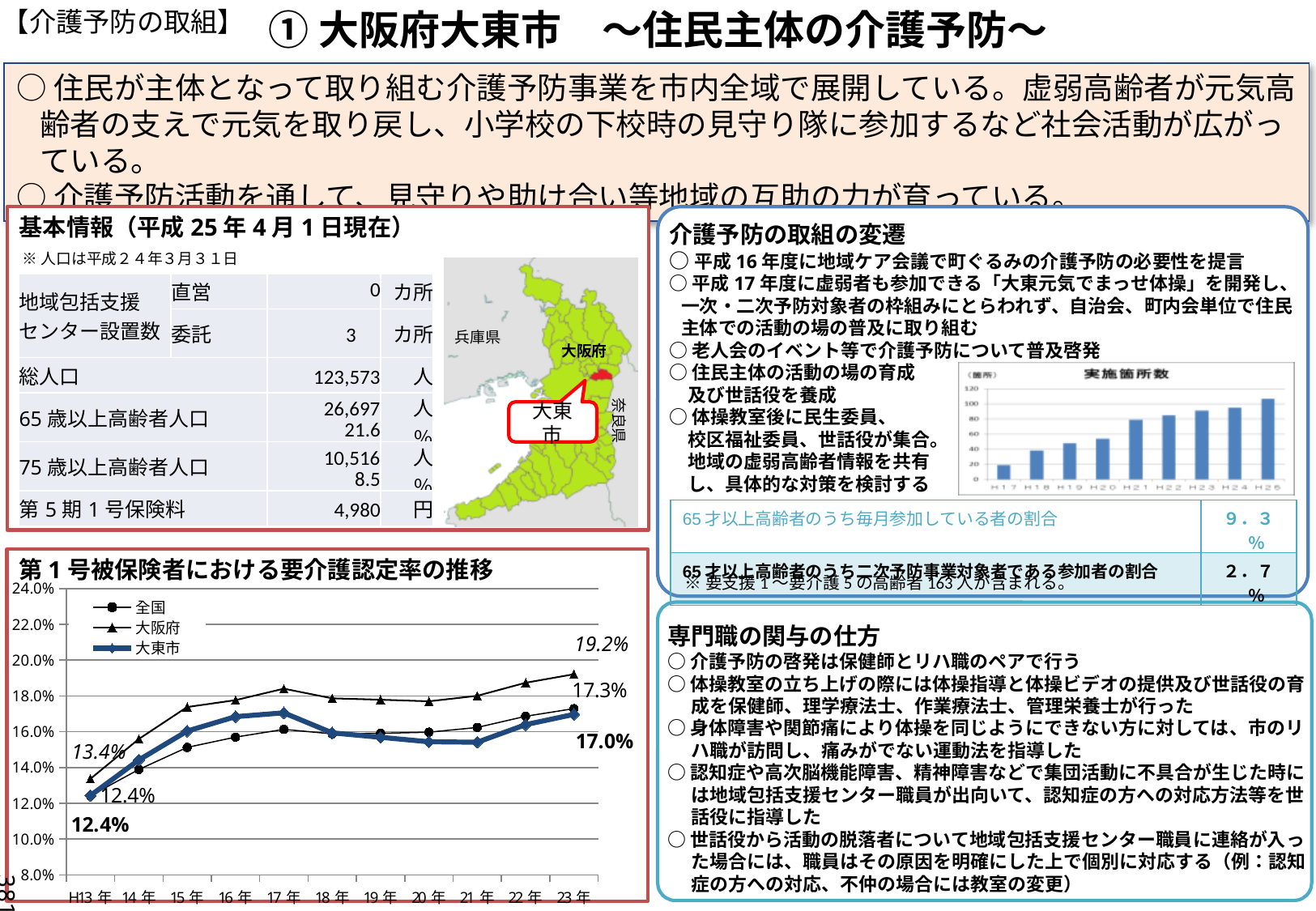
In the chart 第1号被保険者における要介護認定率の推移, how many series does the legend list? 3 In the chart 第1号被保険者における要介護認定率の推移, how many years are plotted along the x axis? 11 In the chart 第1号被保険者における要介護認定率の推移, what is the value for 全国 in 23年? 17.3% In the chart 第1号被保険者における要介護認定率の推移, which series has the highest value in 23年? 大阪府 What kind of chart is the chart titled 第1号被保険者における要介護認定率の推移? Line chart In the chart 第1号被保険者における要介護認定率の推移, what is the value for 大阪府 in 23年? 19.2% In the chart 第1号被保険者における要介護認定率の推移, what is the value for 大阪府 in H13年? 13.4% In the chart 第1号被保険者における要介護認定率の推移, what is the difference between 大阪府 and 大東市 in 23年? 2.2 percentage points In the chart 第1号被保険者における要介護認定率の推移, what is the value for 大東市 in 23年? 17.0% What kind of chart is the chart titled 実施箇所数? Bar chart In the chart 実施箇所数, is the value for H17 greater or less than 40? less In the chart 実施箇所数, how many bars are plotted? 9